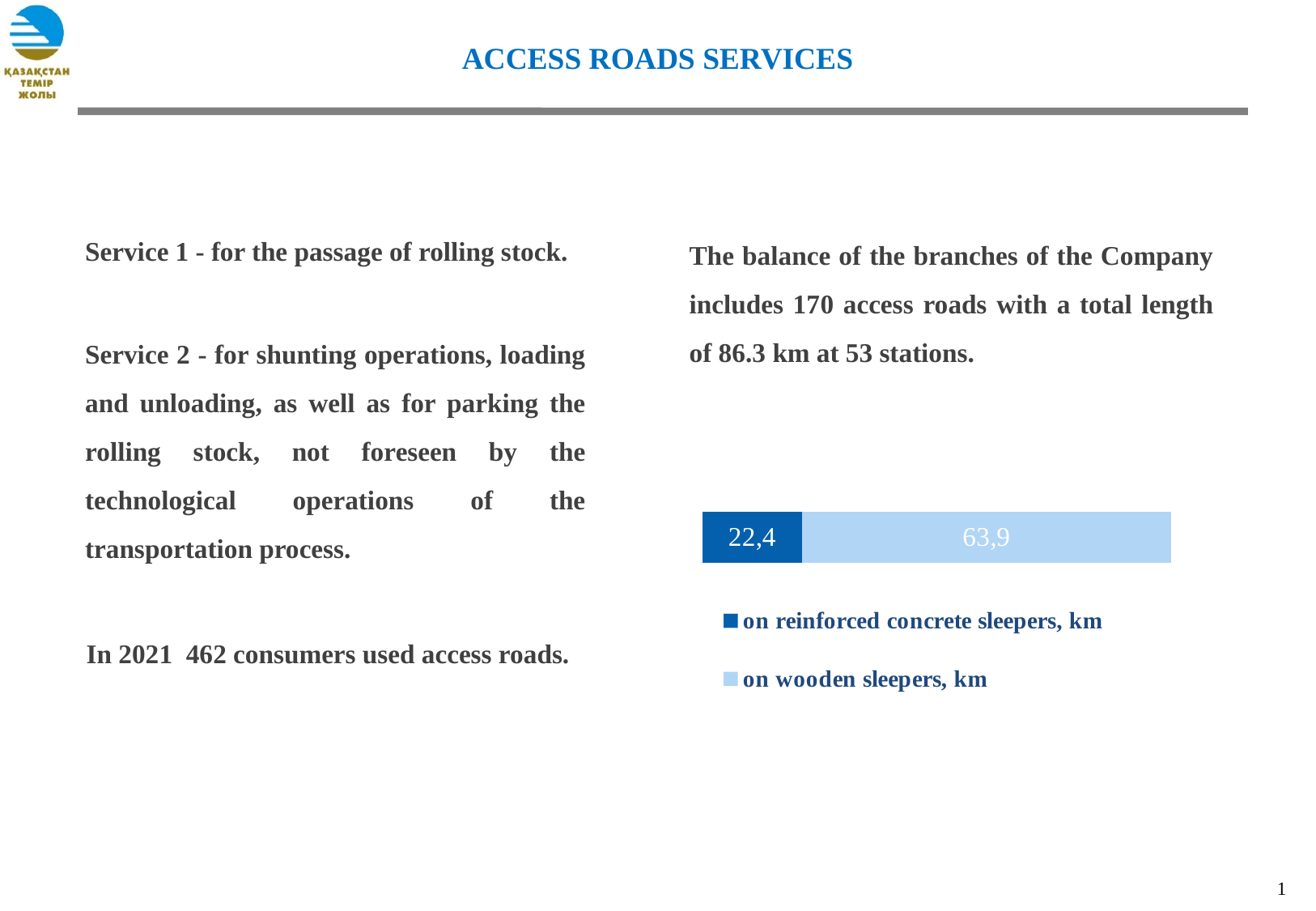
What is the total of the stacked bar? 86,3 How many series does the legend list? 2 What is the value for on reinforced concrete sleepers, km? 22,4 Which series has the largest value in the chart? on wooden sleepers, km What is the value for on wooden sleepers, km? 63,9 Which colour represents on reinforced concrete sleepers, km in the chart? dark blue What is the difference between the value for on wooden sleepers and the value for on reinforced concrete sleepers? 41,5 What kind of chart is shown on the slide? stacked bar chart Which series has the larger value, on reinforced concrete sleepers or on wooden sleepers? on wooden sleepers, km Which colour represents on wooden sleepers, km in the chart? light blue Which series has the smallest value in the chart? on reinforced concrete sleepers, km